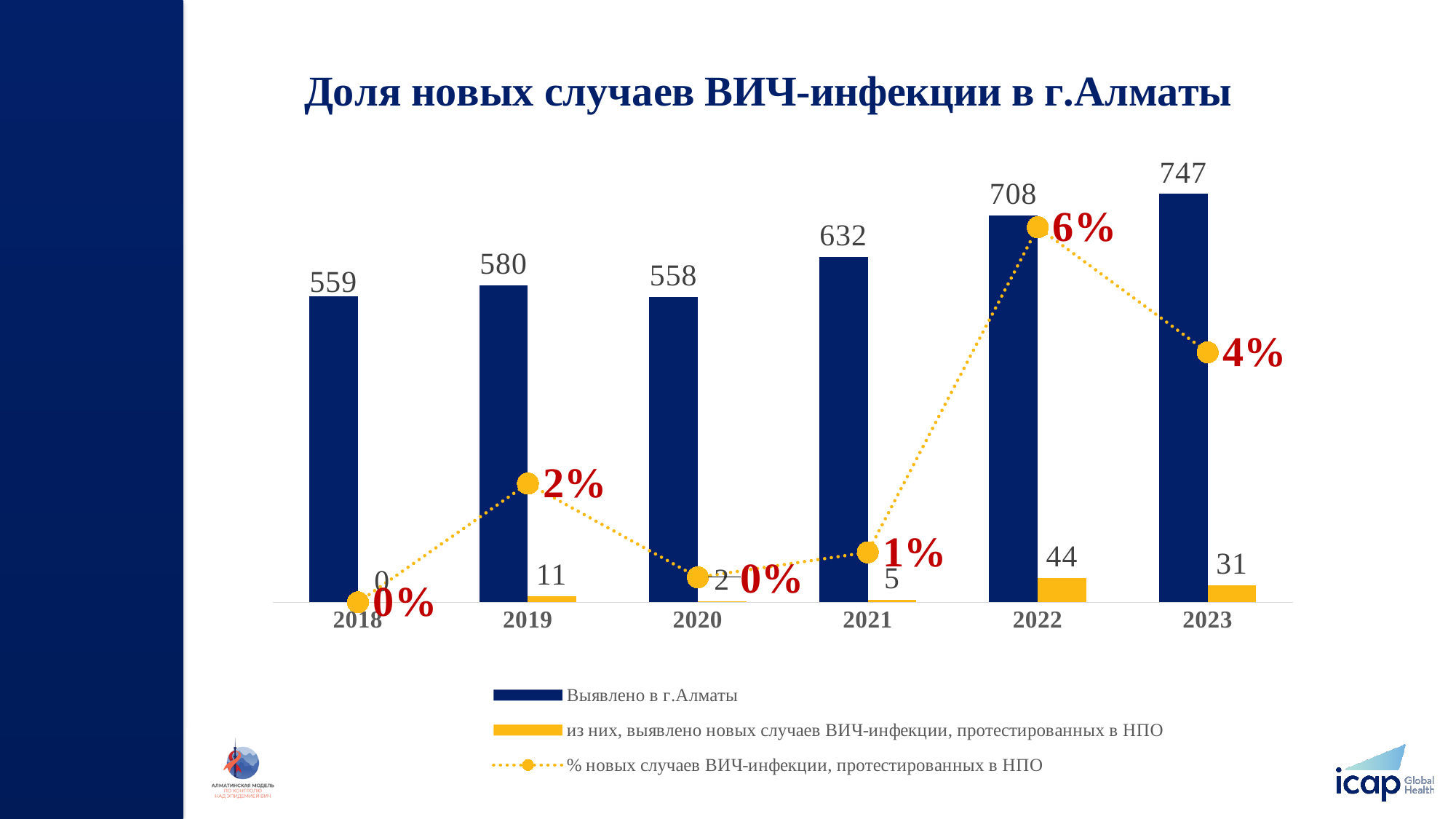
What is the difference between the number of new cases tested in NGOs in 2022 and in 2023? 13 What is the difference between the "Выявлено в г.Алматы" values for 2023 and 2018? 188 Which year has the highest percentage of new HIV cases tested in NGOs? 2022 How many new HIV cases tested in NGOs ("из них, выявлено новых случаев ВИЧ-инфекции, протестированных в НПО") are shown for 2022? 44 Which is larger: the "Выявлено в г.Алматы" value for 2019 or for 2020? 2019 Which year has the highest value for "Выявлено в г.Алматы"? 2023 What is the title of the chart? Доля новых случаев ВИЧ-инфекции в г.Алматы What percentage of new HIV cases tested in NGOs is shown for 2019? 2% Which year has the lowest value for "Выявлено в г.Алматы"? 2020 How many series does the legend list? 3 How many years are shown on the x axis? 6 What is the value of "Выявлено в г.Алматы" for 2023? 747